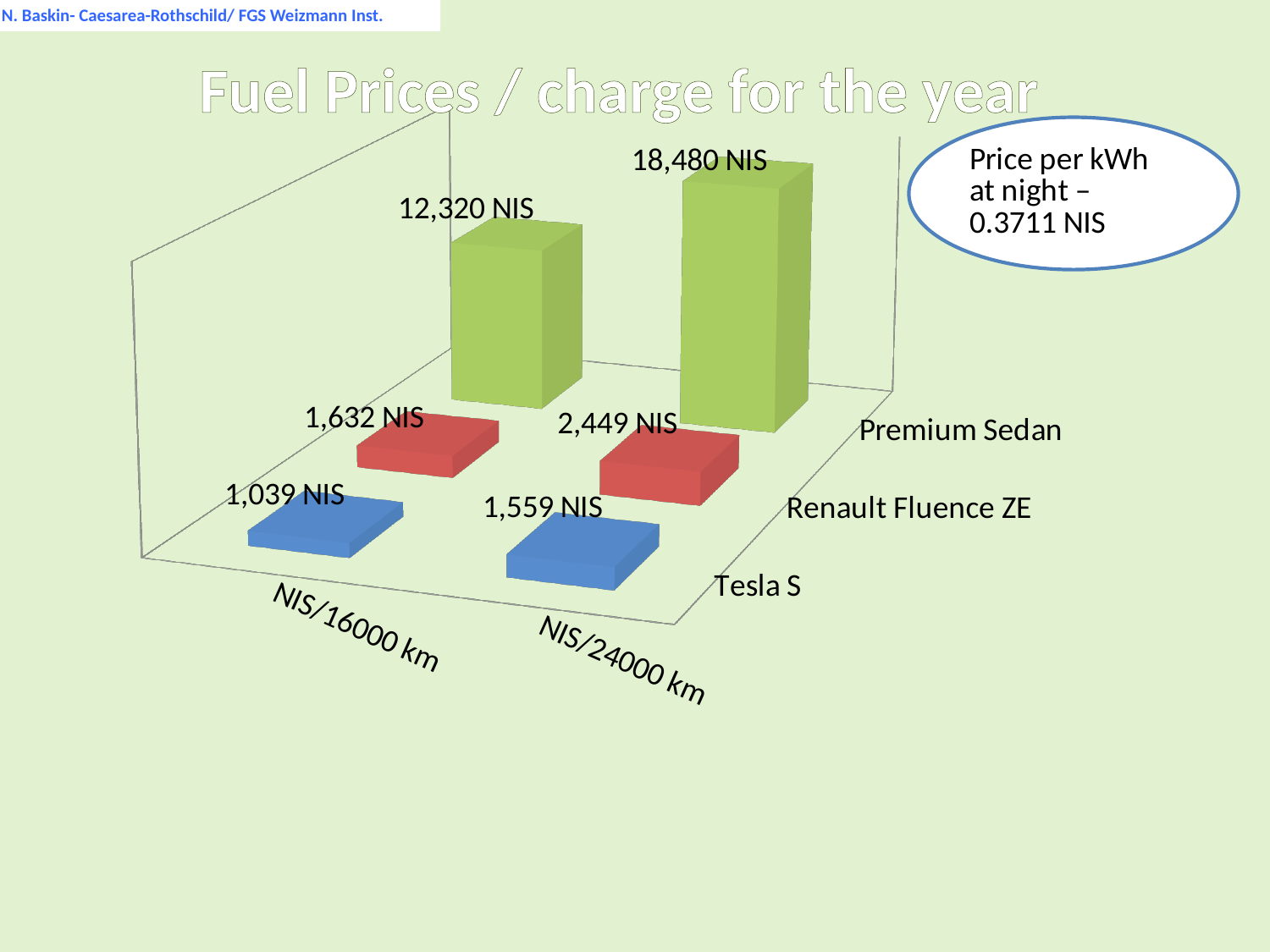
What kind of chart is shown on the slide? Bar chart What is the value for Tesla S at NIS/16000 km? 1,039 NIS How many vehicle series are plotted in the chart? 3 Which is larger: Tesla S at NIS/24000 km or Renault Fluence ZE at NIS/16000 km? Renault Fluence ZE at NIS/16000 km What is the title of the chart? Fuel Prices / charge for the year What is the difference between the Premium Sedan values at NIS/24000 km and NIS/16000 km? 6,160 NIS What is the value for Renault Fluence ZE at NIS/24000 km? 2,449 NIS What is the value for Premium Sedan at NIS/24000 km? 18,480 NIS What is the difference between Renault Fluence ZE and Tesla S at NIS/16000 km? 593 NIS Which vehicle has the highest value at NIS/24000 km? Premium Sedan What is the value for Premium Sedan at NIS/16000 km? 12,320 NIS Which vehicle has the lowest value at NIS/16000 km? Tesla S